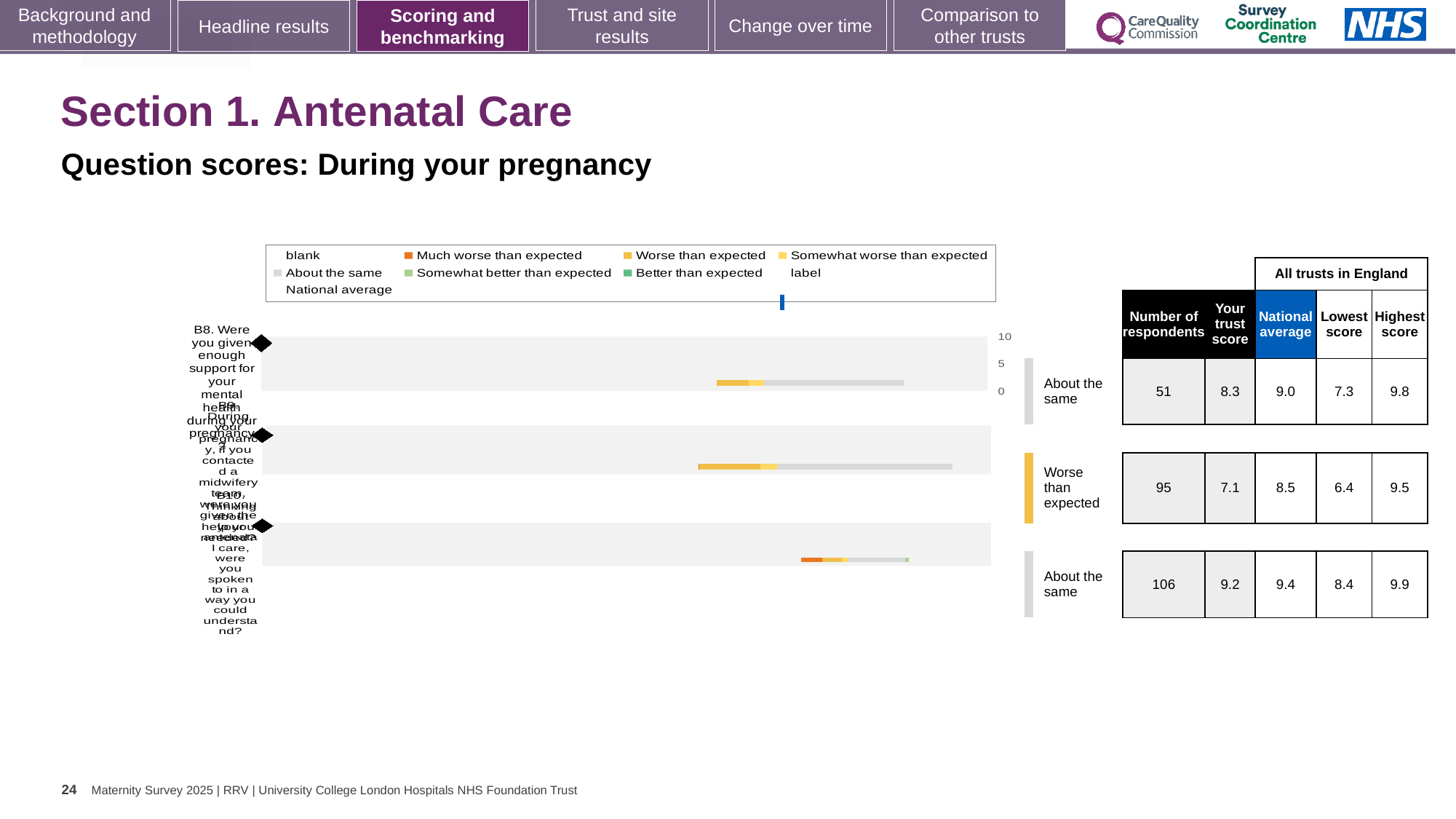
Which row has the lowest trust score? the second row (7.1) Which row has the highest number of respondents? the third row (106) What is the lowest score among all trusts in England for the first row? 7.3 What is the number of respondents for the first row (B8, support for your mental health during pregnancy)? 51 What benchmark label is shown for the second row? Worse than expected Is the trust score for the third row larger or smaller than its national average? smaller What is the national average for the second row of the table? 8.5 What is the trust score for the first row (B8, support for your mental health during pregnancy)? 8.3 How many question rows are plotted in the chart? 3 What is the difference between the national average and the trust score for the second row? 1.4 What kind of chart is shown on the slide? bar chart What is the highest score among all trusts in England for the third row of the table? 9.9